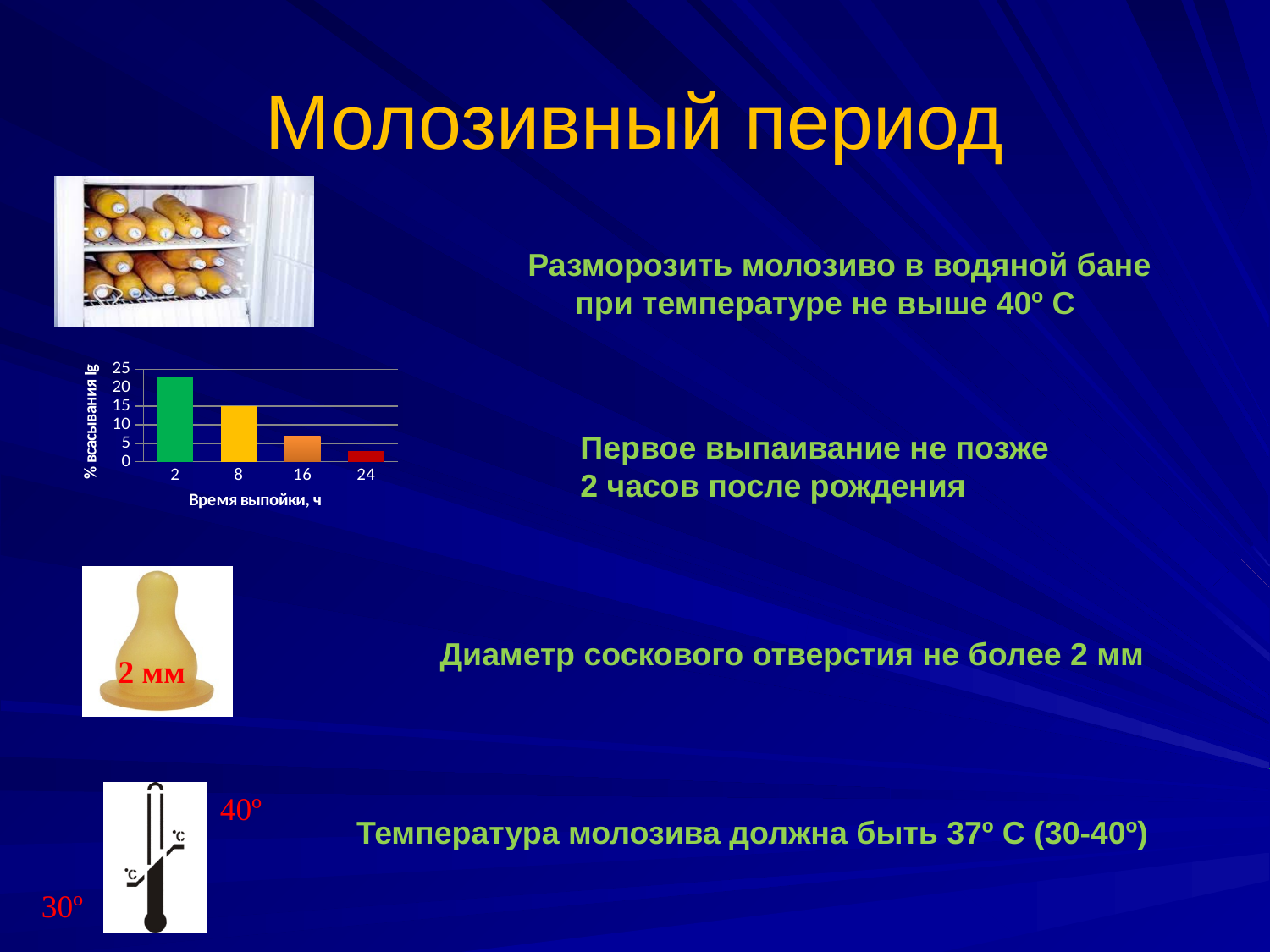
Is the value for feeding time 24 greater or less than 5? less Do the values rise or fall as feeding time increases along the x axis? fall Which feeding time (Время выпойки, ч) has the lowest % всасывания Ig? 24 Which feeding time (Время выпойки, ч) has the highest % всасывания Ig? 2 What is the title of the y axis of the bar chart? % всасывания Ig What kind of chart is shown on the slide? bar chart Which is larger, the value for feeding time 8 or for feeding time 16? 8 How many categories are shown on the x axis of the bar chart? 4 Is the value for feeding time 2 greater or less than 20? greater Is the value for feeding time 16 greater or less than 10? less What is the title of the x axis of the bar chart? Время выпойки, ч